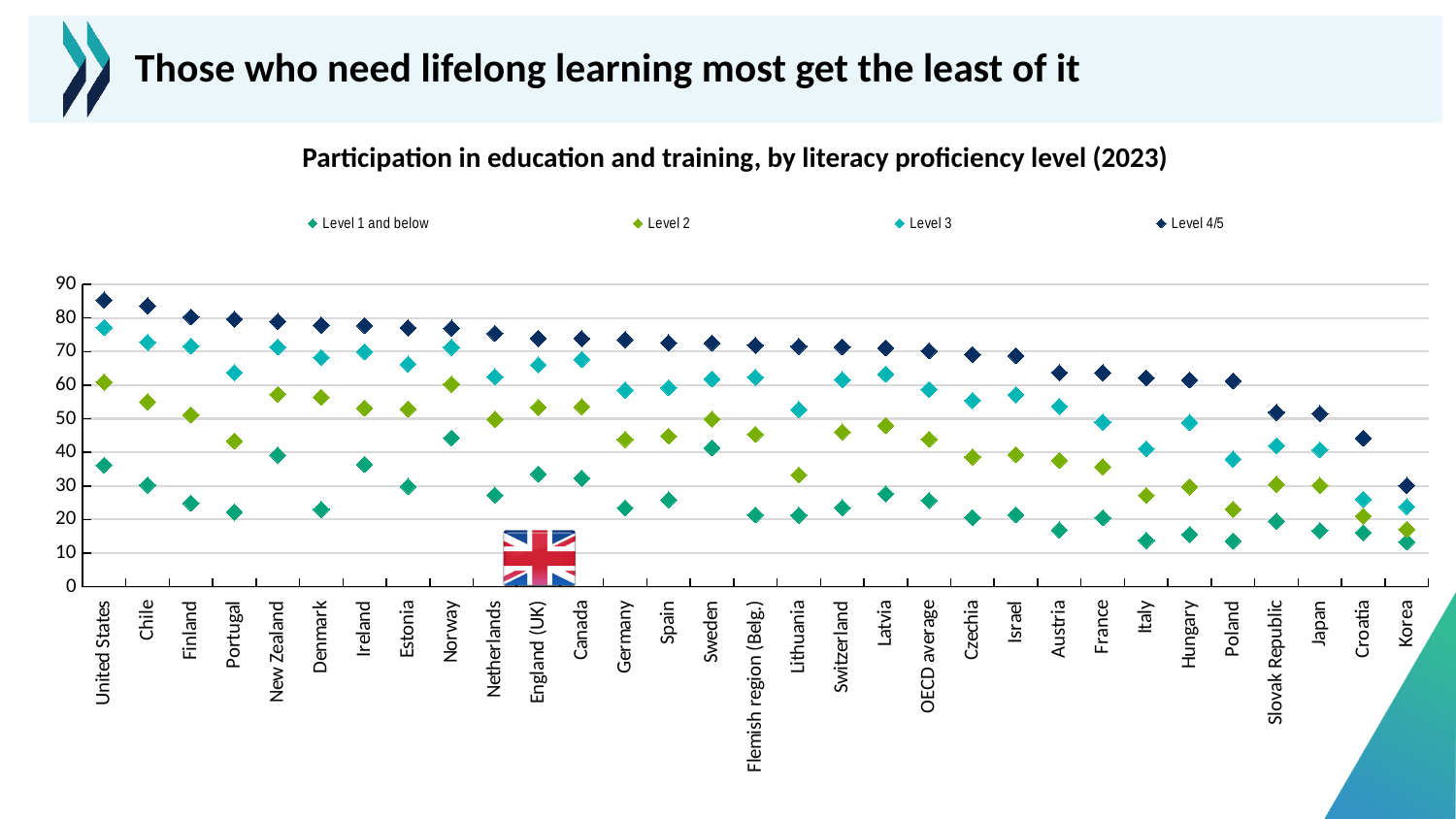
How many series does the legend list? 4 Is the Level 1 and below value for Portugal greater or less than 30? less Is the Level 1 and below value for Austria greater or less than 20? less How many countries or regions are shown on the x axis? 31 What kind of chart is shown on the slide? Scatter (dot) chart Do the Level 4/5 values generally rise or fall from left to right along the x axis? fall Which country has the highest value for Level 4/5? United States Which country has the lowest value for Level 4/5? Korea Is the Level 4/5 value for the United States greater or less than 80? greater Which is larger for Germany: the Level 3 value or the Level 1 and below value? Level 3 What is the title of the chart? Participation in education and training, by literacy proficiency level (2023)